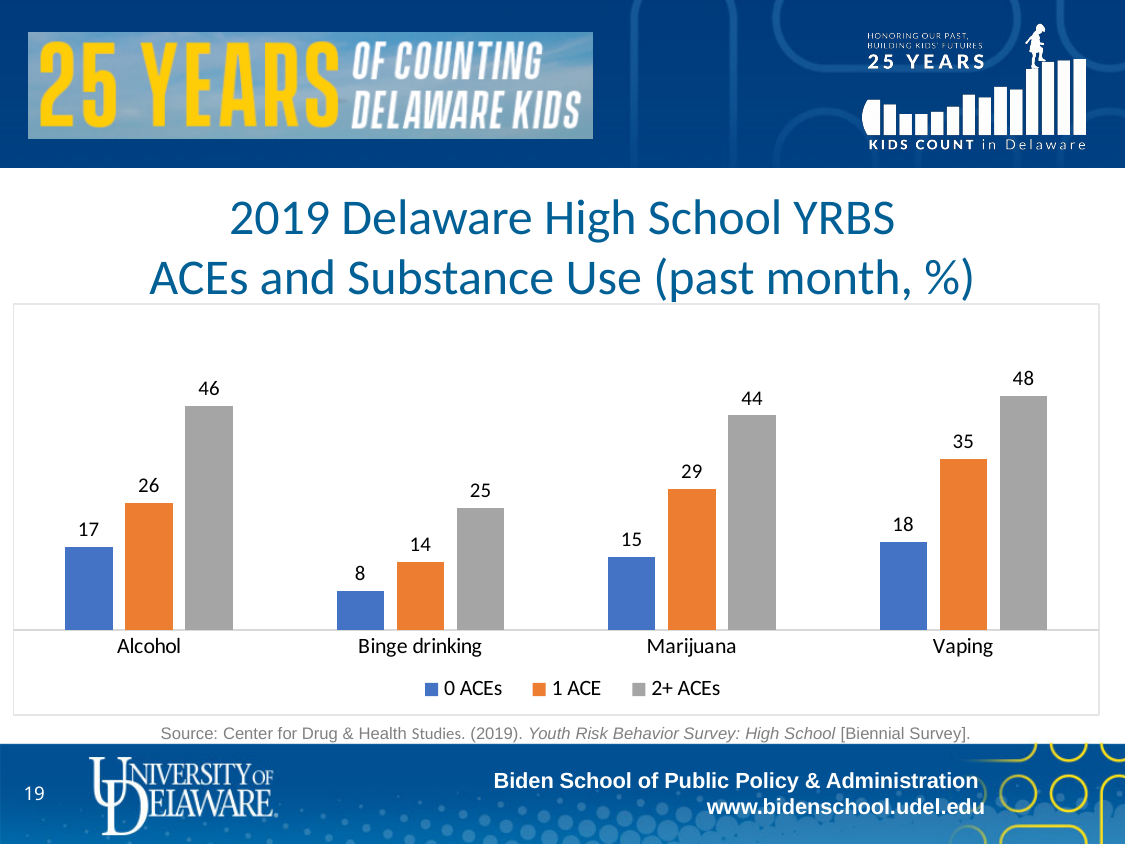
What colour represents the 1 ACE series in the chart? Orange What is the value for 2+ ACEs in the Vaping category? 48 What is the value for 0 ACEs in the Binge drinking category? 8 How many series does the legend list? 3 How many categories are shown on the x axis? 4 Which category has the lowest value for the 0 ACEs series? Binge drinking Which is larger: the 1 ACE value for Vaping or the 1 ACE value for Alcohol? Vaping What kind of chart is shown on the slide? Bar chart What is the difference between the 2+ ACEs and 0 ACEs values for Alcohol? 29 What is the value for 1 ACE in the Marijuana category? 29 Within the Marijuana category, do the values rise or fall from 0 ACEs to 2+ ACEs? Rise Which category has the highest value for the 2+ ACEs series? Vaping